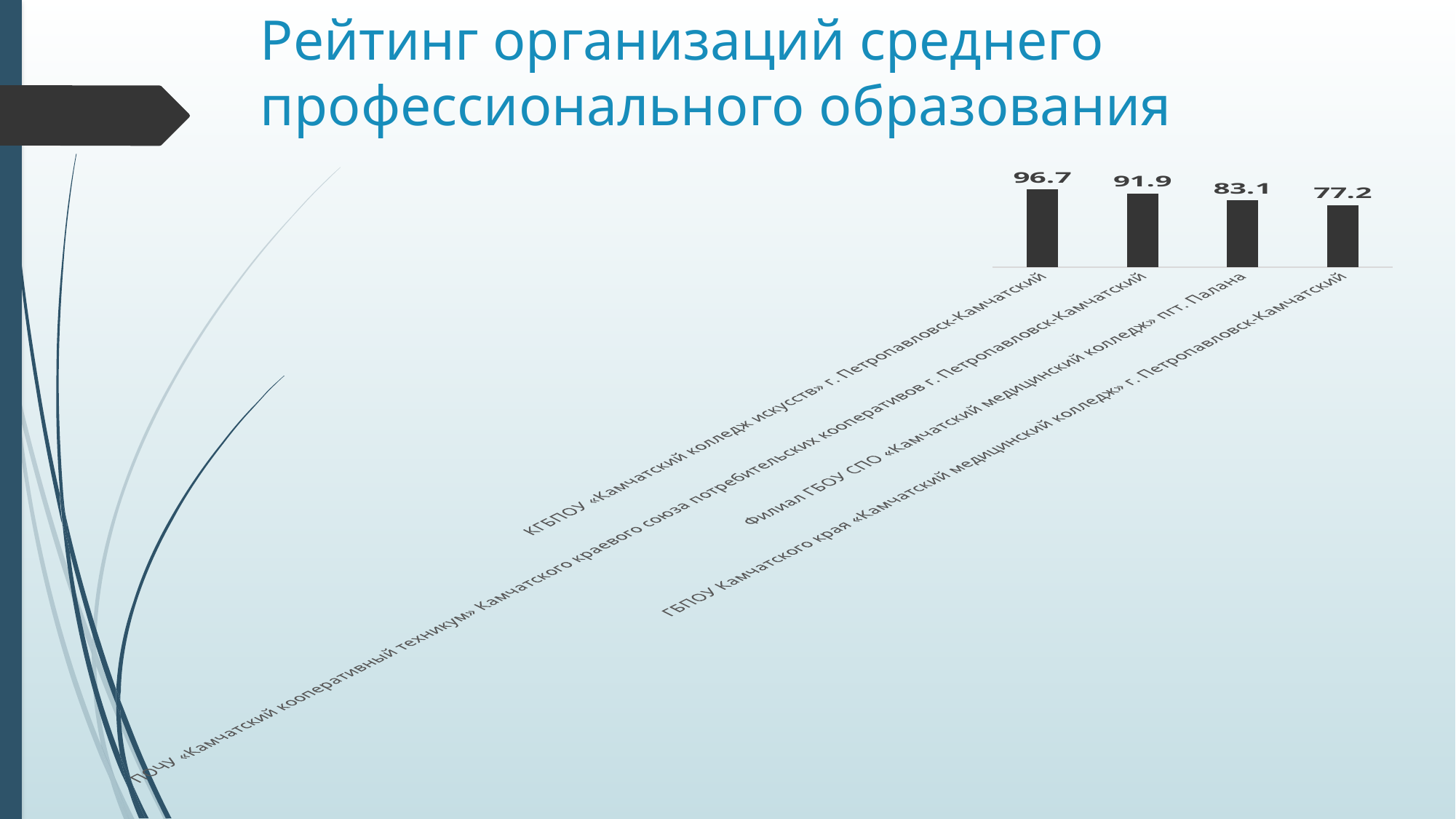
Which has a larger value: Филиал ГБОУ СПО «Камчатский медицинский колледж» пгт. Палана or ГБПОУ Камчатского края «Камчатский медицинский колледж» г. Петропавловск-Камчатский? Филиал ГБОУ СПО «Камчатский медицинский колледж» пгт. Палана Which organisation has the highest value in the chart? КГБПОУ «Камчатский колледж искусств» г. Петропавловск-Камчатский What is the value for ГБПОУ Камчатского края «Камчатский медицинский колледж» г. Петропавловск-Камчатский? 77.2 How many organisations are shown in the chart? 4 What kind of chart is shown on the slide? Bar chart What is the difference between the values for ПОЧУ «Камчатский кооперативный техникум» and Филиал ГБОУ СПО «Камчатский медицинский колледж» пгт. Палана? 8.8 What is the value for Филиал ГБОУ СПО «Камчатский медицинский колледж» пгт. Палана? 83.1 What is the value for КГБПОУ «Камчатский колледж искусств» г. Петропавловск-Камчатский? 96.7 Which organisation has the lowest value in the chart? ГБПОУ Камчатского края «Камчатский медицинский колледж» г. Петропавловск-Камчатский What is the value for ПОЧУ «Камчатский кооперативный техникум»? 91.9 Do the values rise or fall from left to right across the chart? Fall What is the difference between the highest and lowest values in the chart? 19.5